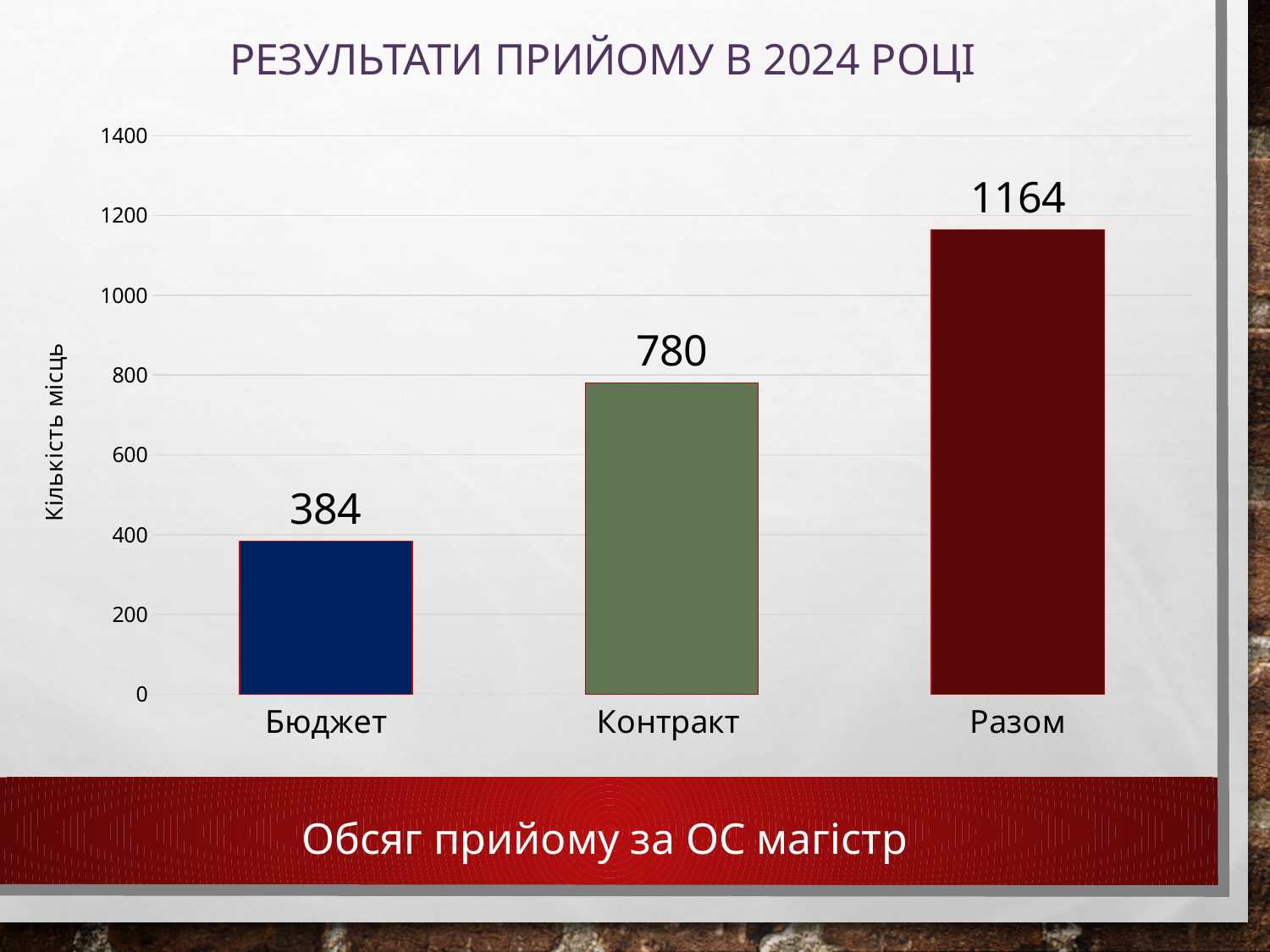
What is the value for Разом? 1164 What kind of chart is shown on the slide? bar chart Which is larger, the value for Бюджет or the value for Контракт? Контракт What is the label of the vertical axis? Кількість місць What is the value for Контракт? 780 Which category has the lowest value? Бюджет Which category has the highest value? Разом What is the value for Бюджет? 384 How many categories are shown on the x axis? 3 What is the difference between the values for Разом and Контракт? 384 Is the value for Разом greater or less than 1000? greater What is the difference between the values for Контракт and Бюджет? 396